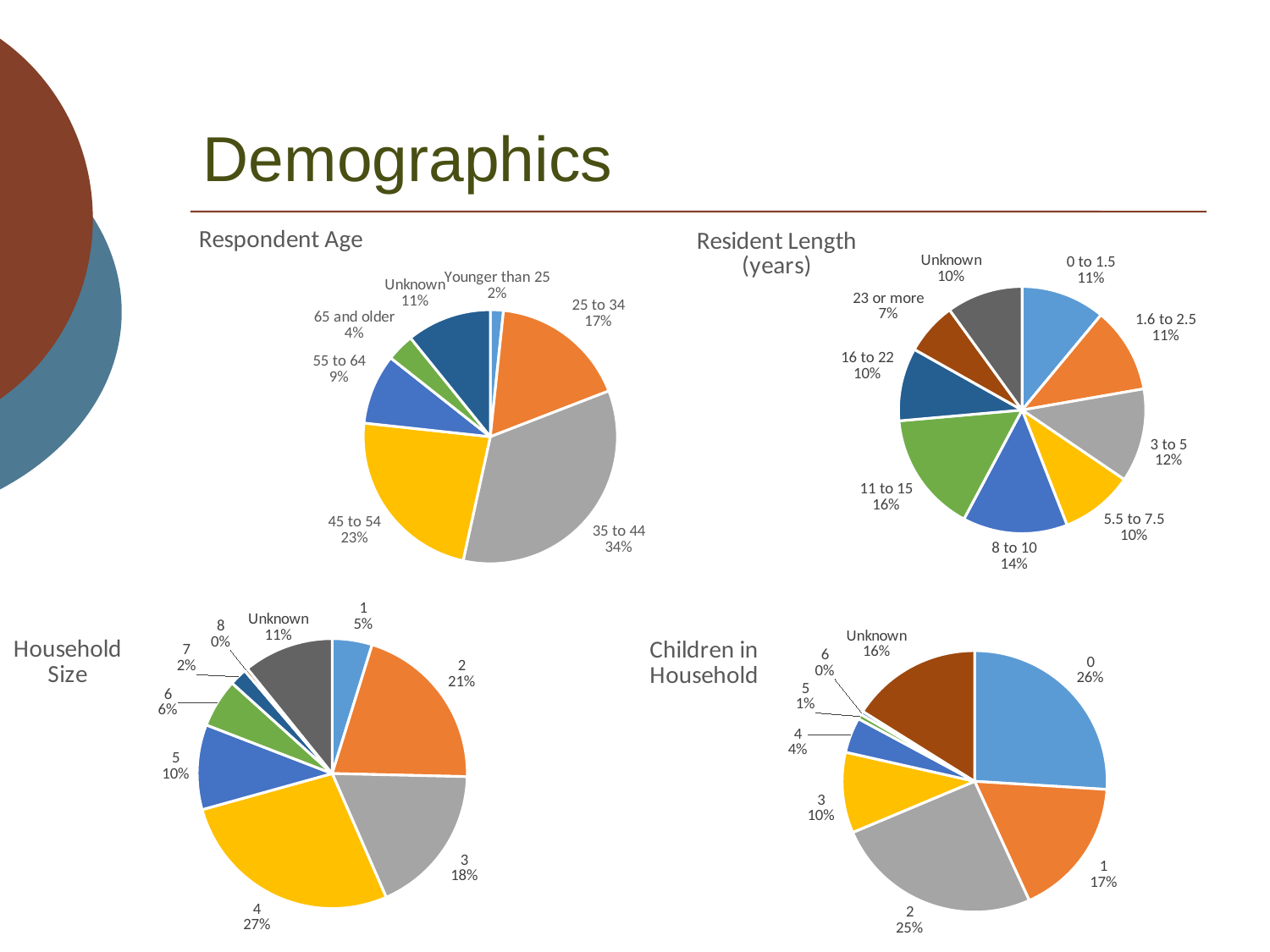
In the Respondent Age chart, what is the difference in percentage points between the 45 to 54 and 25 to 34 slices? 6 How many slices does the Resident Length (years) chart have? 9 In the Household Size chart, which is larger, the slice for 2 or the slice for 3? 2 In the Children in Household chart, what is the difference in percentage points between the 2 and 1 slices? 8 What type of chart is the Children in Household chart? Pie chart In the Children in Household chart, what share of households have 0 children? 26% In the Respondent Age chart, what share of respondents are 35 to 44? 34% In the Respondent Age chart, which age group has the smallest share? Younger than 25 In the Resident Length (years) chart, what share of respondents have lived there 11 to 15 years? 16% In the Resident Length (years) chart, which category has the smallest share? 23 or more In the Household Size chart, what share of households have 4 members? 27% In the Respondent Age chart, which age group has the largest share? 35 to 44